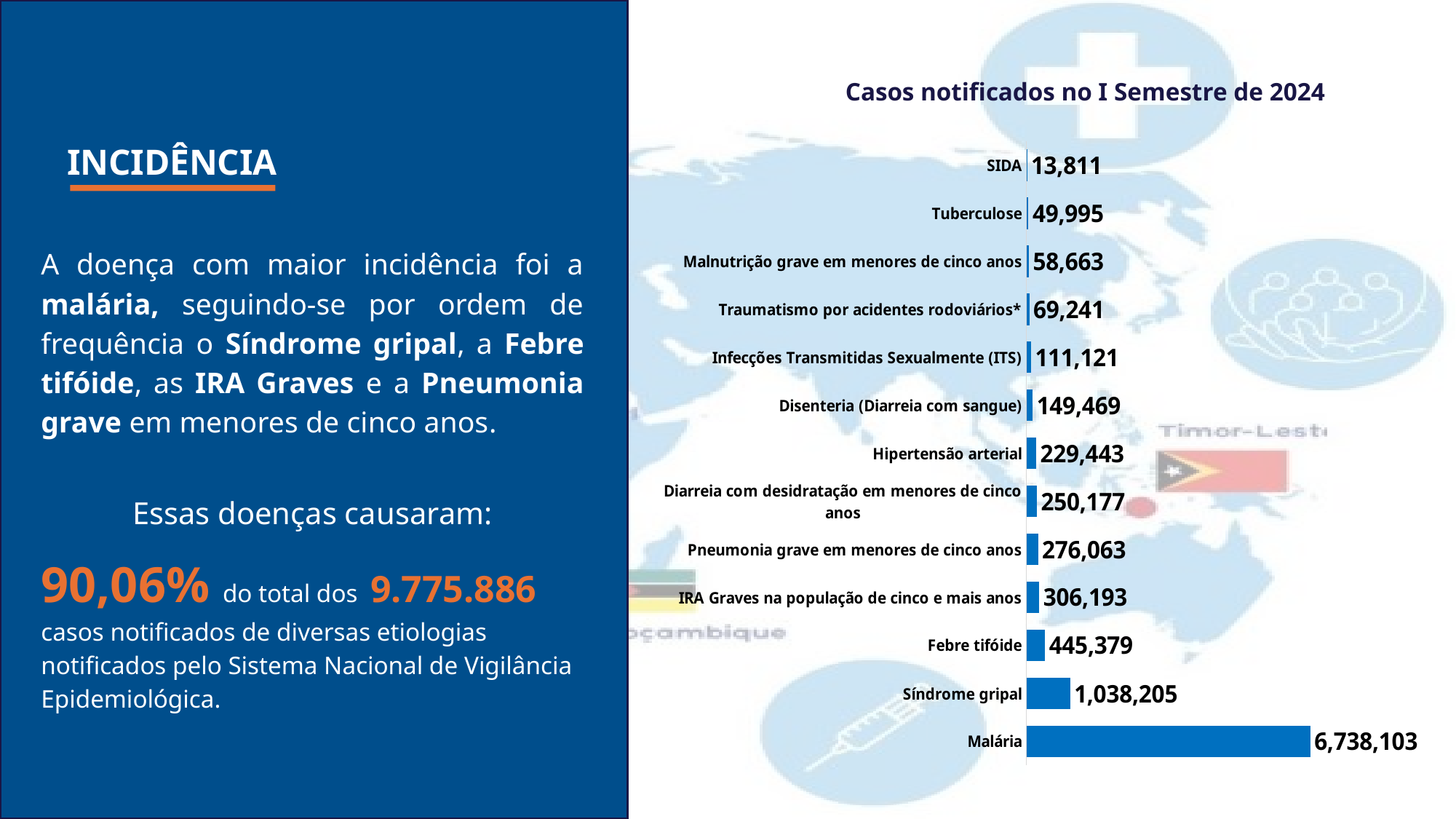
Which has more notified cases: Febre tifóide or IRA Graves na população de cinco e mais anos? Febre tifóide What is the difference between the cases for Tuberculose and SIDA? 36,184 Which category has the highest number of notified cases? Malária What is the number of notified cases for Hipertensão arterial? 229,443 What is the difference between the cases for Malária and Síndrome gripal? 5,699,898 What is the number of notified cases for Síndrome gripal? 1,038,205 How many categories (diseases) are shown in the chart? 13 What type of chart is shown on the slide? Bar chart What is the number of notified cases for Tuberculose? 49,995 What is the title of the chart? Casos notificados no I Semestre de 2024 Which category has the lowest number of notified cases? SIDA What is the number of notified cases for Malária? 6,738,103